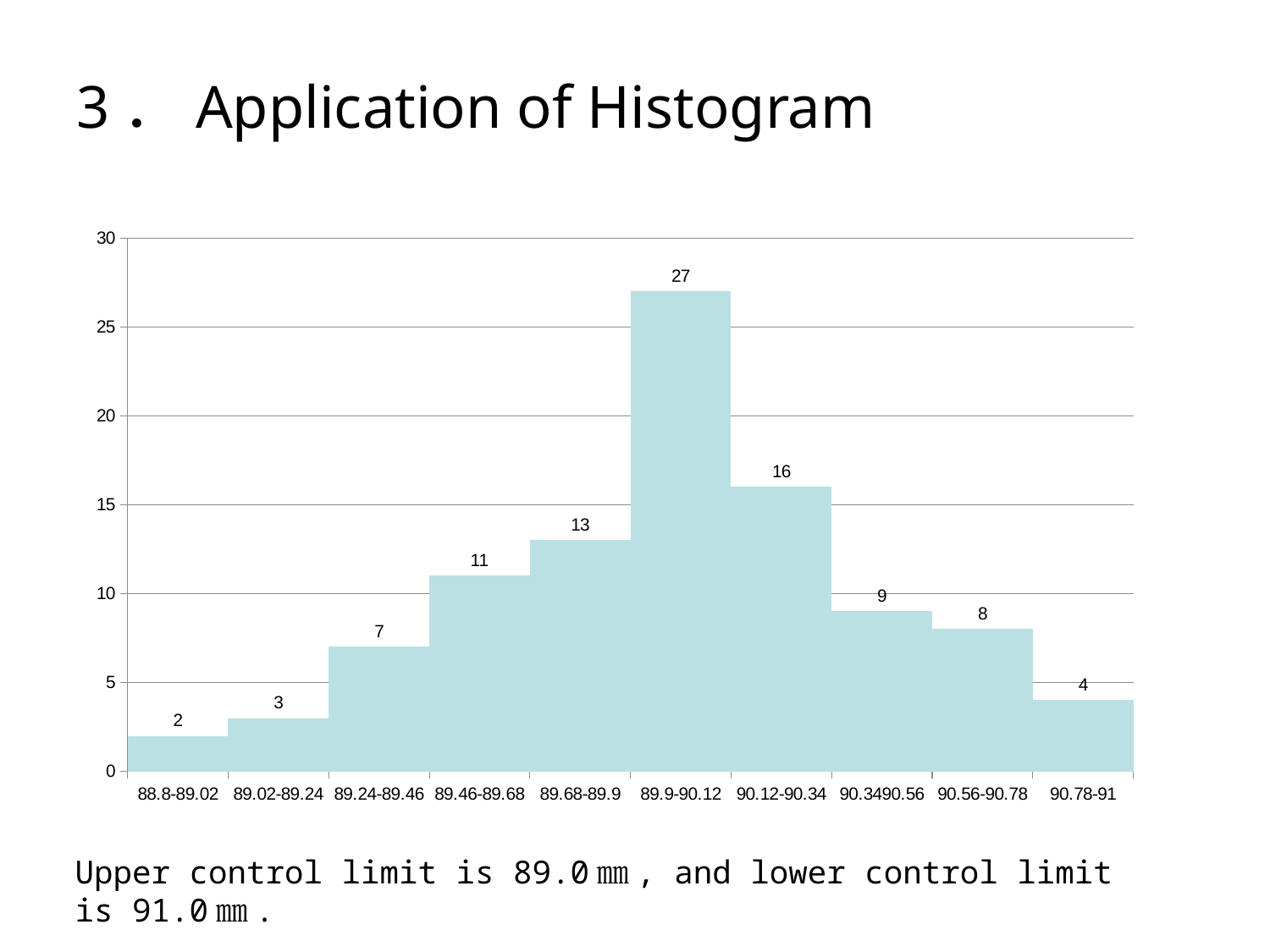
Which is larger, the value for 89.46-89.68 or the value for 90.34-90.56? 89.46-89.68 What is the value for the 89.9-90.12 bin? 27 Is the value for 89.68-89.9 greater or less than 10? greater What is the value for the 90.56-90.78 bin? 8 What is the difference between the values for 89.9-90.12 and 90.12-90.34? 11 Which bin has the lowest value? 88.8-89.02 What is the value for the 88.8-89.02 bin? 2 Do the values rise or fall from the 89.9-90.12 bin to the 90.78-91 bin? fall What is the maximum value shown on the y axis? 30 Which bin has the highest value? 89.9-90.12 How many bins are shown on the x axis? 10 What kind of chart is shown on the slide? bar chart